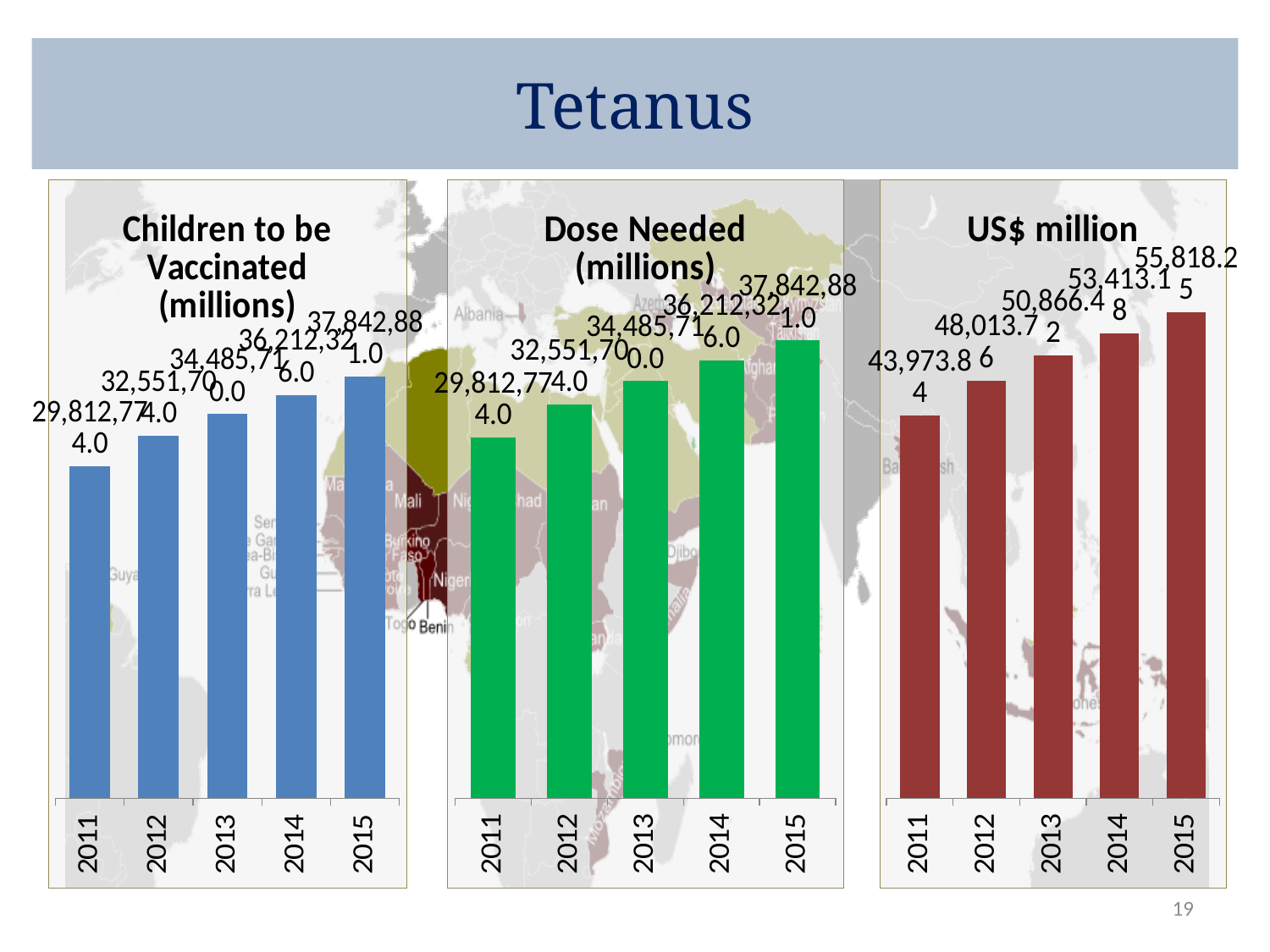
In the 'Dose Needed (millions)' chart, which is larger, the value for 2011 or the value for 2014? 2014 In the 'Children to be Vaccinated (millions)' chart, do the values rise or fall from 2011 to 2015? rise How many years are shown on the x axis of the 'Dose Needed (millions)' chart? 5 In the 'US$ million' chart, which year has the lowest value? 2011 In the 'Dose Needed (millions)' chart, which year has the highest value? 2015 What kind of chart is the 'Children to be Vaccinated (millions)' chart? bar chart In the 'Dose Needed (millions)' chart, do the values rise or fall along the x axis? rise In the 'Children to be Vaccinated (millions)' chart, which year has the lowest value? 2011 In the 'US$ million' chart, which is larger, the value for 2012 or the value for 2015? 2015 In the 'Children to be Vaccinated (millions)' chart, which year has the highest value? 2015 What colour are the bars in the 'Dose Needed (millions)' chart? green What colour are the bars in the 'US$ million' chart? dark red